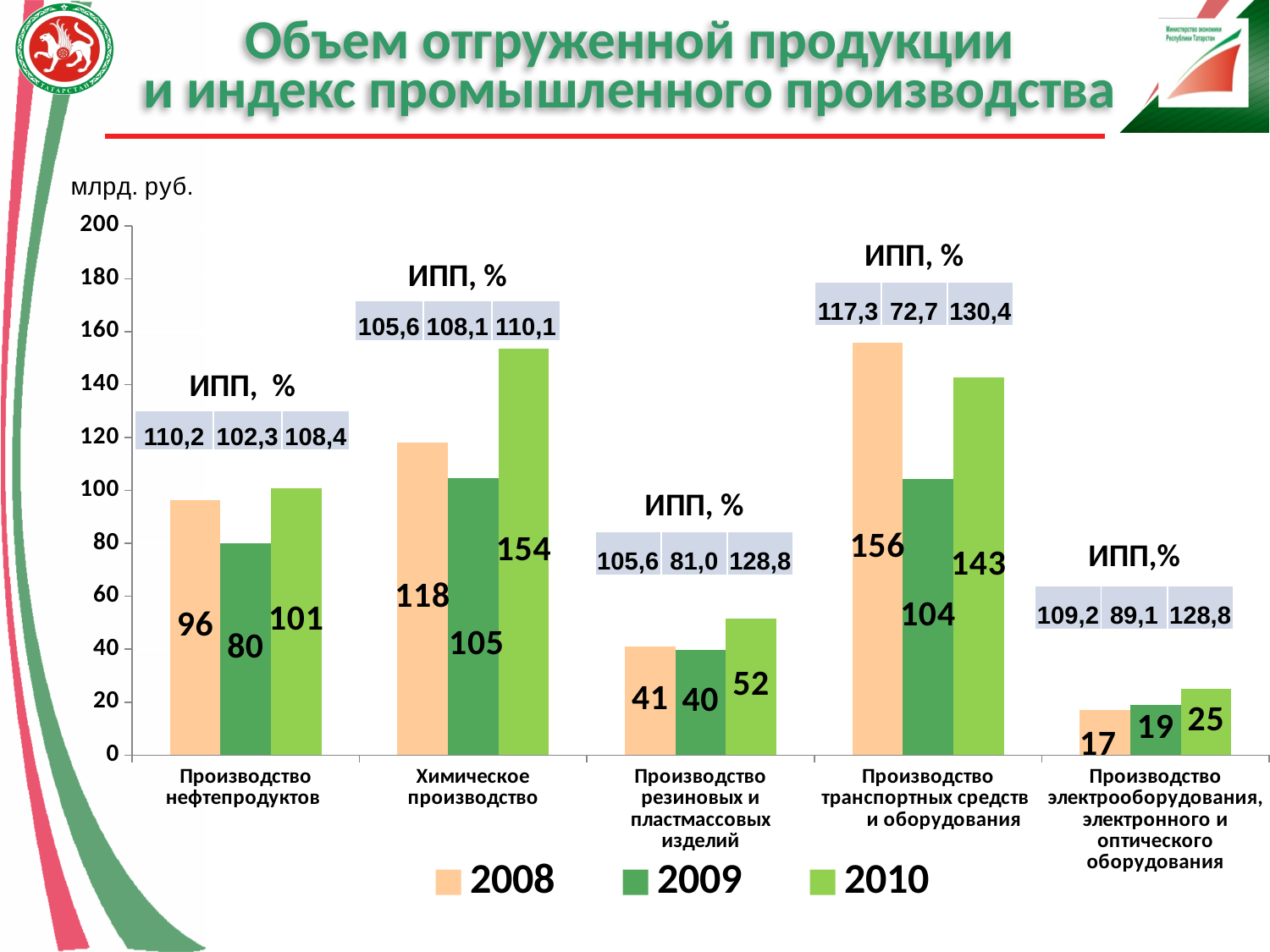
Which is larger: the 2008 value for Производство транспортных средств и оборудования or the 2010 value for Химическое производство? 2008 value for Производство транспортных средств и оборудования What unit is shown above the y axis? млрд. руб. Which category has the lowest value in 2010? Производство электрооборудования, электронного и оптического оборудования What is the value for Производство нефтепродуктов in 2008? 96 Which category has the highest value in 2008? Производство транспортных средств и оборудования What kind of chart is shown on the slide? bar chart What is the value for Химическое производство in 2010? 154 What is the difference between the 2010 and 2008 values for Химическое производство? 36 What is the ИПП, % value shown for 2009 for Производство резиновых и пластмассовых изделий? 81,0 How many categories are shown on the x axis? 5 How many series does the legend list? 3 What is the value for Производство транспортных средств и оборудования in 2009? 104